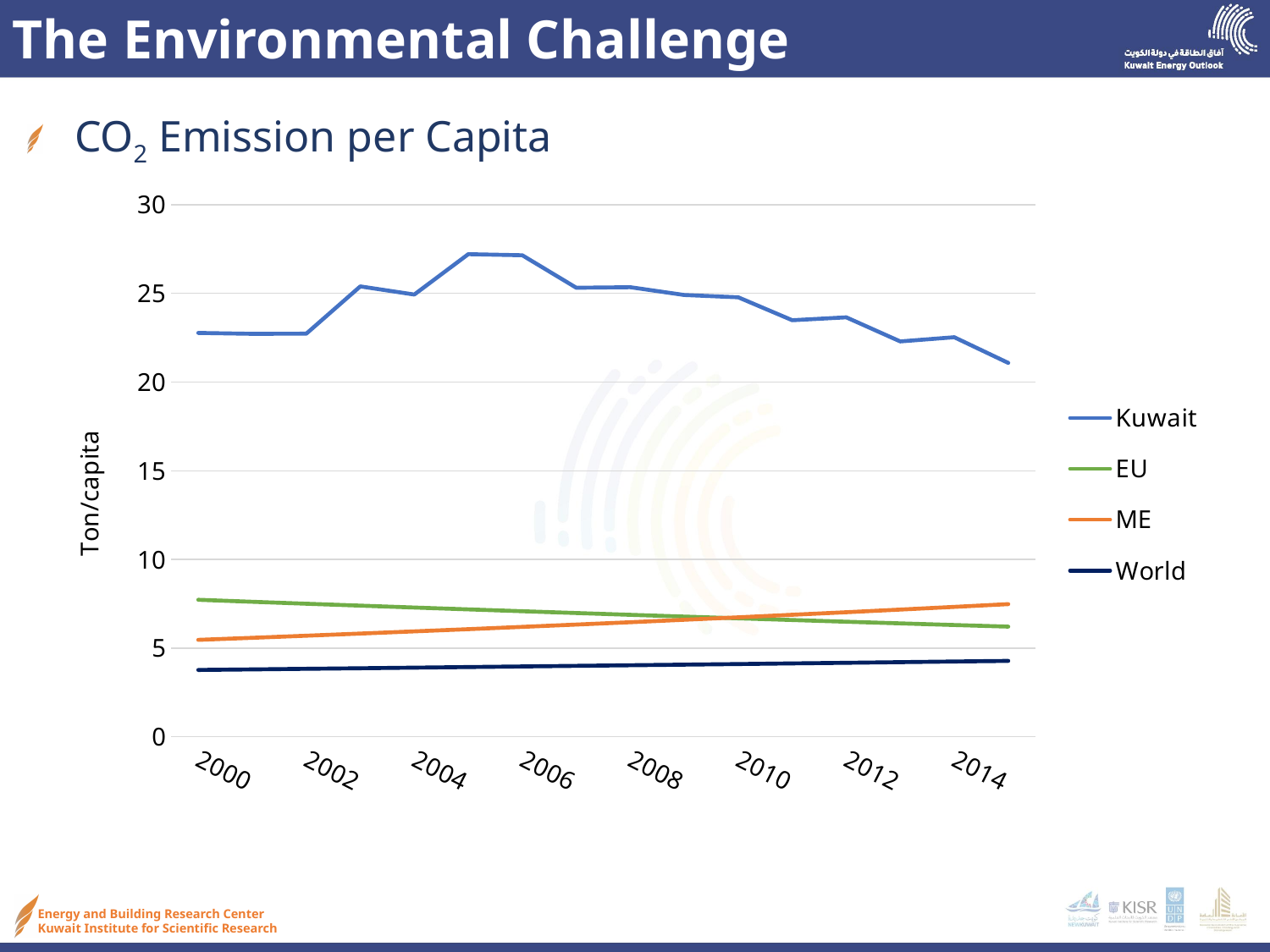
Which series has the lowest CO2 emission per capita throughout the period? World Is the value for Kuwait in 2014 greater or less than 25? less Which series has the highest CO2 emission per capita throughout the period? Kuwait Is the value for EU in 2000 greater or less than 10? less Does the ME series rise or fall from 2000 to 2014? rise What kind of chart is shown on the slide? line chart What is the label on the vertical axis? Ton/capita In 2014, which is larger, the value for EU or the value for ME? ME Is the value for World in 2000 greater or less than 5? less Which series are listed in the legend? Kuwait, EU, ME, World How many series does the legend list? 4